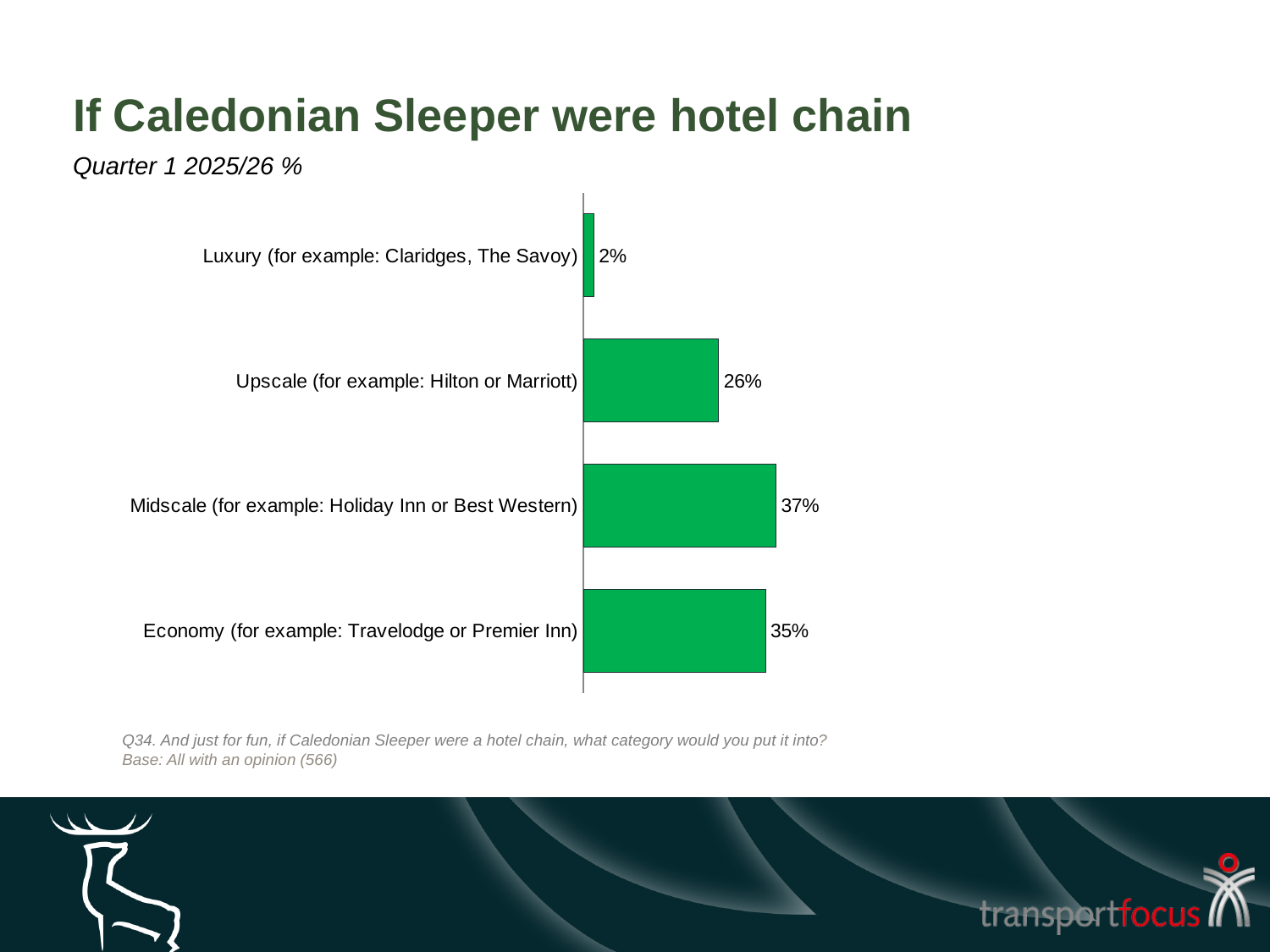
Which hotel category has the lowest percentage? Luxury (for example: Claridges, The Savoy) Which is larger, the value for Upscale or the value for Economy? Economy Which hotel category has the highest percentage? Midscale (for example: Holiday Inn or Best Western) What type of chart is shown on the slide? Bar chart What is the difference between the Midscale and Economy percentages? 2% What is the subtitle shown beneath the chart title? Quarter 1 2025/26 % What is the difference between the Upscale and Luxury percentages? 24% What is the value shown for Economy (for example: Travelodge or Premier Inn)? 35% What is the value shown for Luxury (for example: Claridges, The Savoy)? 2% How many hotel categories are shown in the chart? 4 What percentage of respondents put Caledonian Sleeper in the Midscale (for example: Holiday Inn or Best Western) category? 37% What is the value shown for Upscale (for example: Hilton or Marriott)? 26%